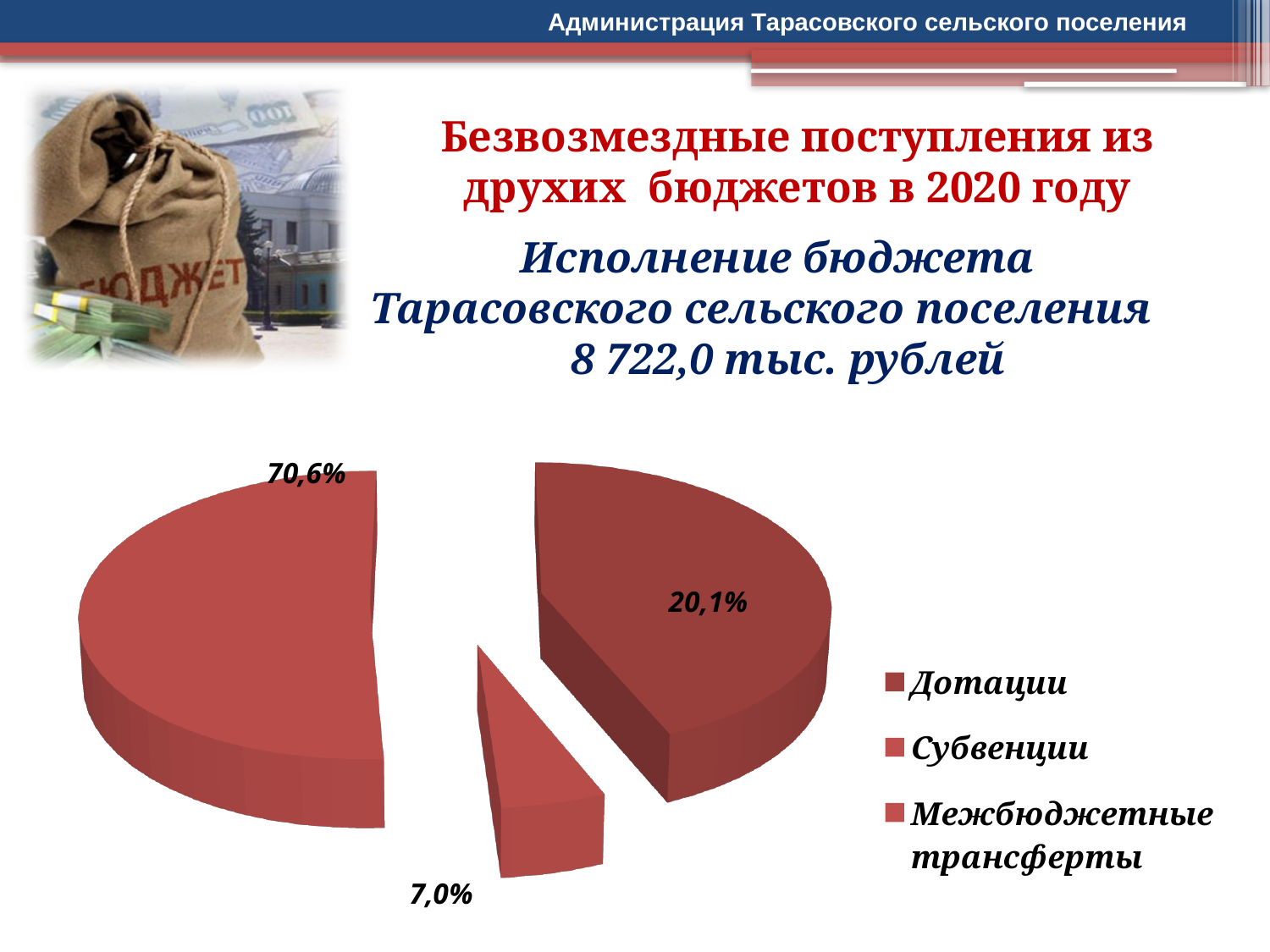
What total amount of gratuitous receipts is stated in the slide title? 8 722,0 тыс. рублей What is the difference in percentage points between the largest slice (70,6%) and the 20,1% slice? 50,5 What is the value of the largest slice in the pie chart? 70,6% What kind of chart is shown on the slide? Pie chart What is the value of the smallest slice in the pie chart? 7,0% Which is larger: the slice on the right of the pie or the slice at the bottom of the pie? The slice on the right (20,1%) What are the three legend entries of the pie chart? Дотации, Субвенции, Межбюджетные трансферты How many slices does the pie chart have? 3 What share of the pie does the largest slice represent? 70,6% What is the difference in percentage points between the 20,1% slice and the 7,0% slice? 13,1 How many entries does the legend of the pie chart list? 3 Is the value of the largest slice greater or less than 50%? greater